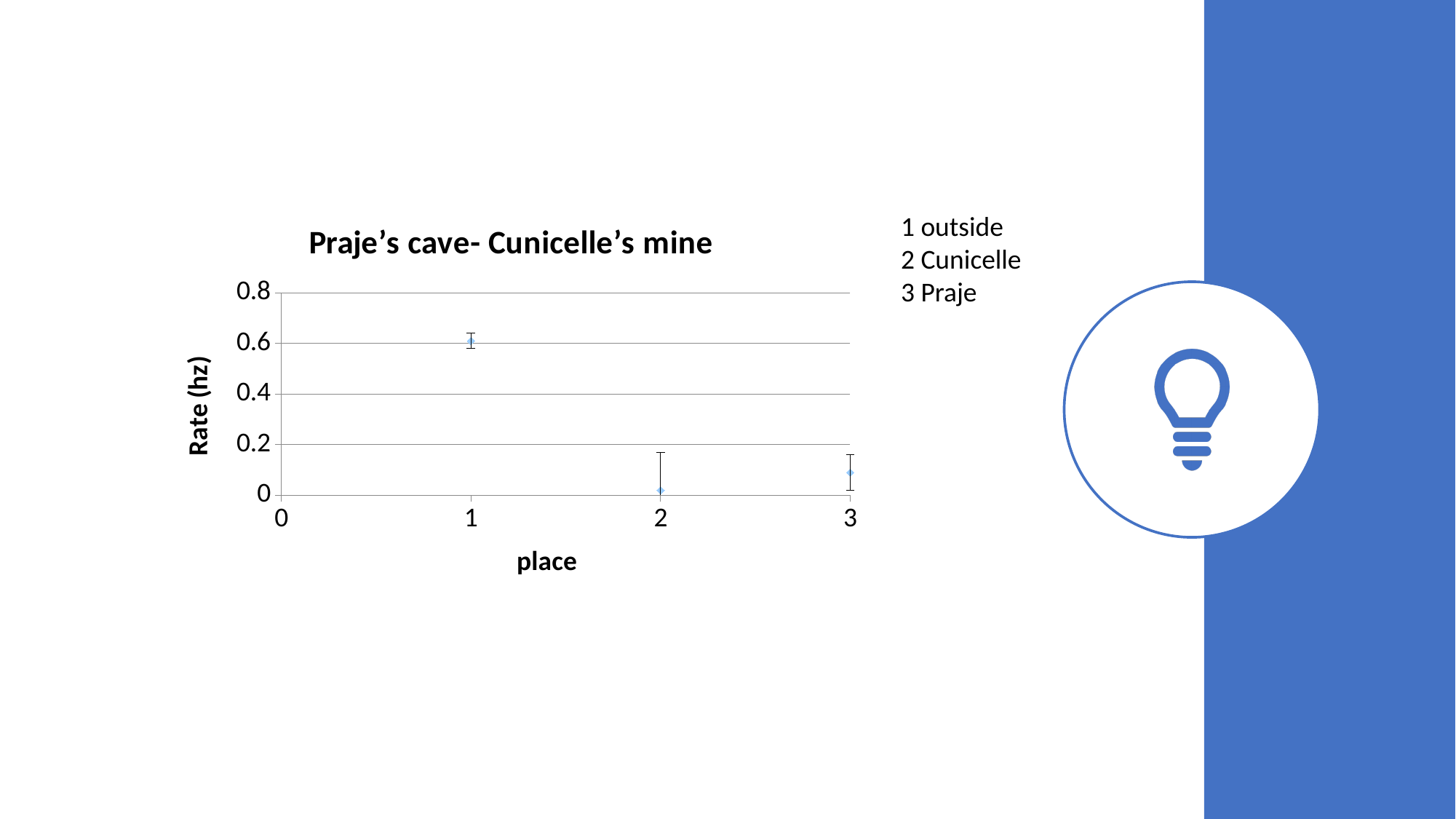
Is the rate for place 1 greater or less than 0.4? greater Which place has the highest rate? Place 1 What is the label of the y axis? Rate (hz) Is the rate for place 3 greater or less than 0.2? less Does the rate rise or fall from place 1 to place 2? Fall What kind of chart is shown on the slide? Scatter chart Which place has the lowest rate? Place 2 Is the rate for place 1 greater or less than 0.8? less Which has a higher rate, place 1 or place 3? Place 1 How many data points are plotted on the chart? 3 What is the title of the chart? Praje's cave- Cunicelle's mine